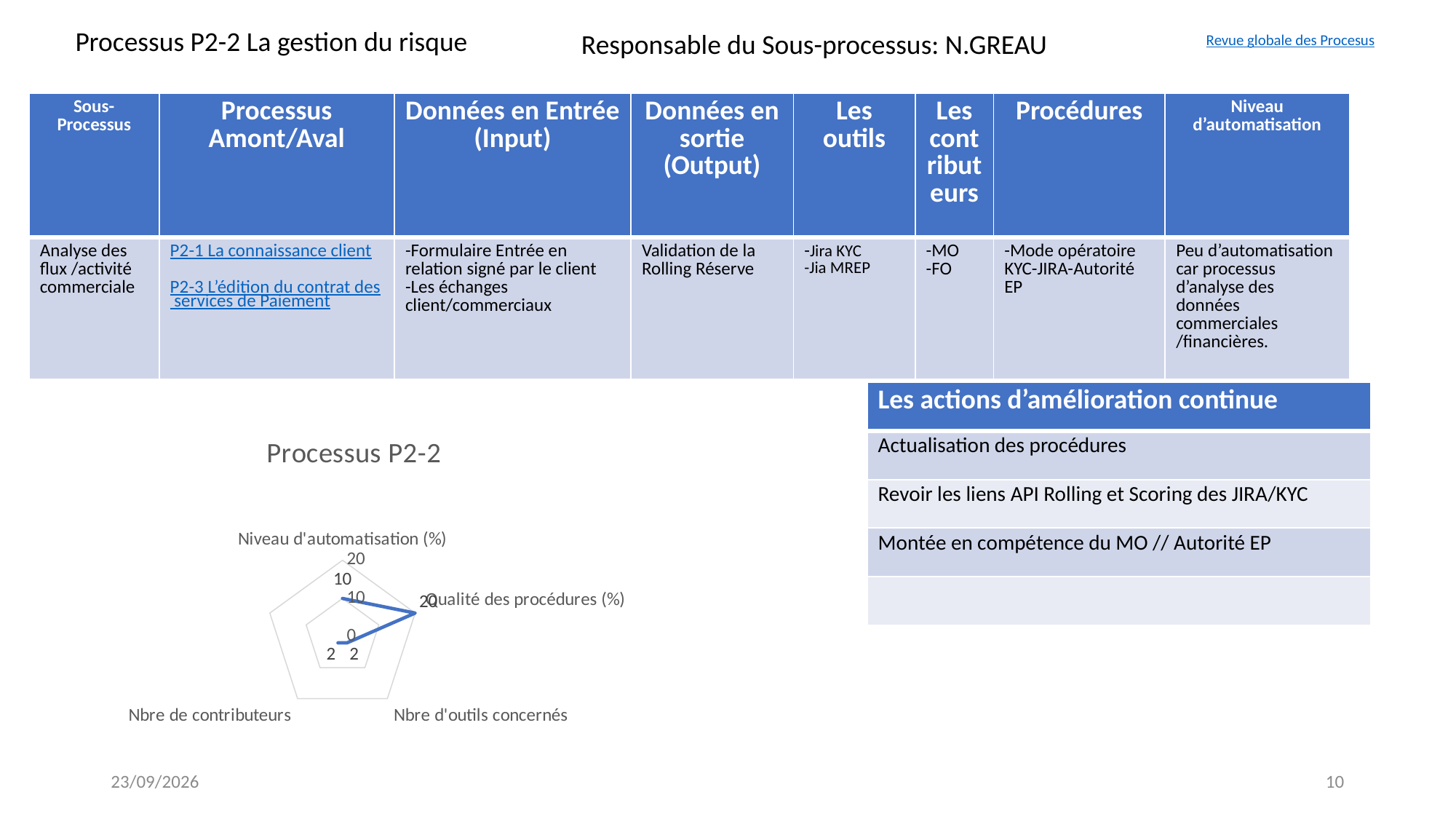
Which is larger, the value for Niveau d'automatisation (%) or the value for Qualité des procédures (%)? Qualité des procédures (%) What is the value for Nbre d'outils concernés in the chart? 2 What is the title of the chart? Processus P2-2 What is the value for Niveau d'automatisation (%) in the chart? 10 What kind of chart is shown on the slide? radar chart Is the value for Qualité des procédures (%) greater or less than 10? greater What is the value for Qualité des procédures (%) in the chart? 20 What is the difference between the value for Qualité des procédures (%) and the value for Niveau d'automatisation (%)? 10 Which axis has the highest value in the chart? Qualité des procédures (%) What is the value for Nbre de contributeurs in the chart? 2 What is the highest tick value shown on the chart's scale? 20